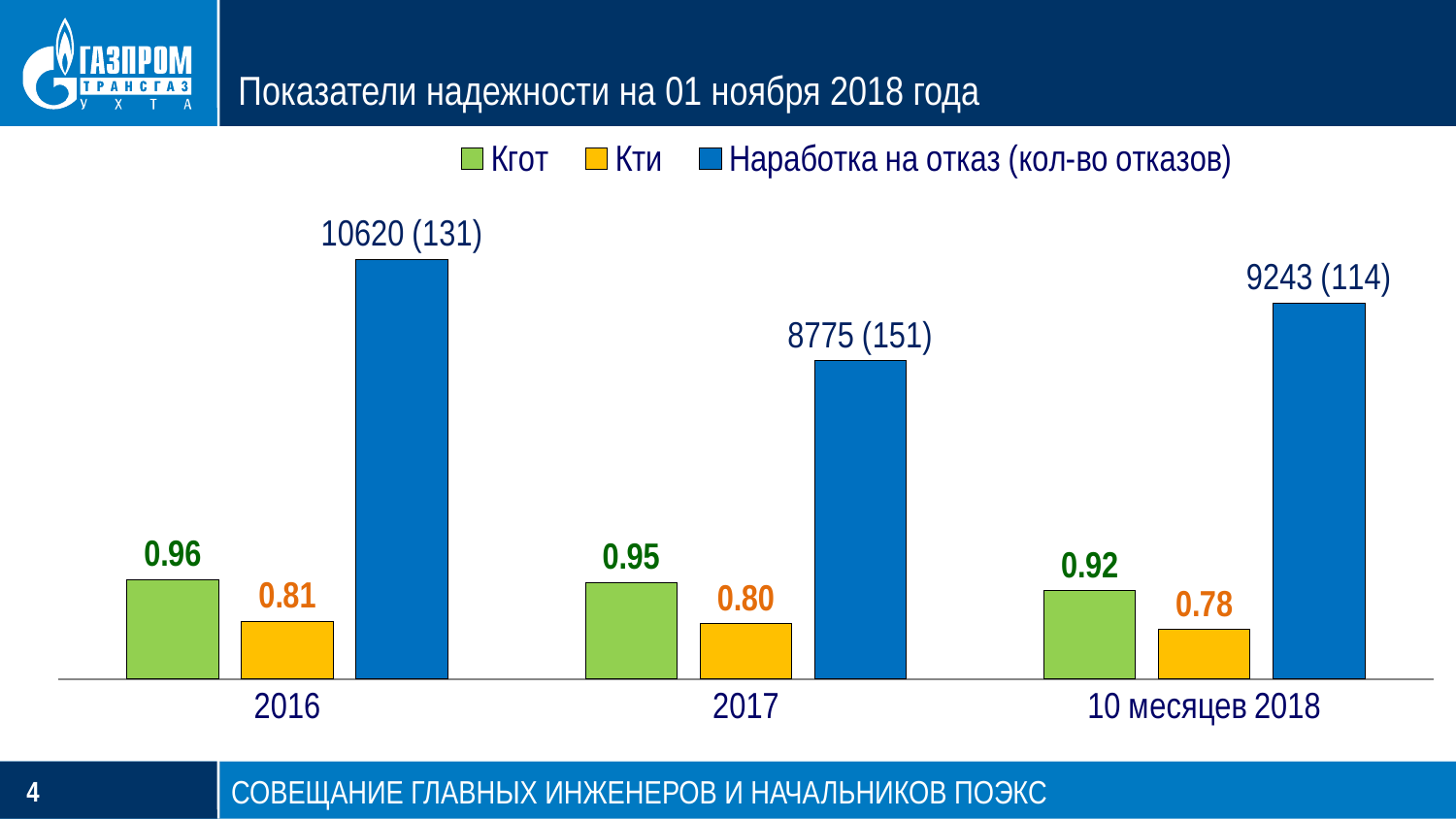
What is the data label on the Наработка на отказ bar for 10 месяцев 2018? 9243 (114) How many categories are shown on the x axis? 3 What is the data label on the Наработка на отказ bar for 2017? 8775 (151) What is the difference between Кгот in 2016 and Кгот in 10 месяцев 2018? 0.04 In which category is Кти the lowest? 10 месяцев 2018 In which category is Наработка на отказ the highest? 2016 Which is larger: Наработка на отказ in 2017 or in 10 месяцев 2018? 10 месяцев 2018 What is the value of Кгот for 2016? 0.96 What is the value of Кти for 2017? 0.80 How many series does the legend list? 3 Does Кгот rise or fall from 2016 to 10 месяцев 2018? Fall What kind of chart is shown on the slide? Bar chart